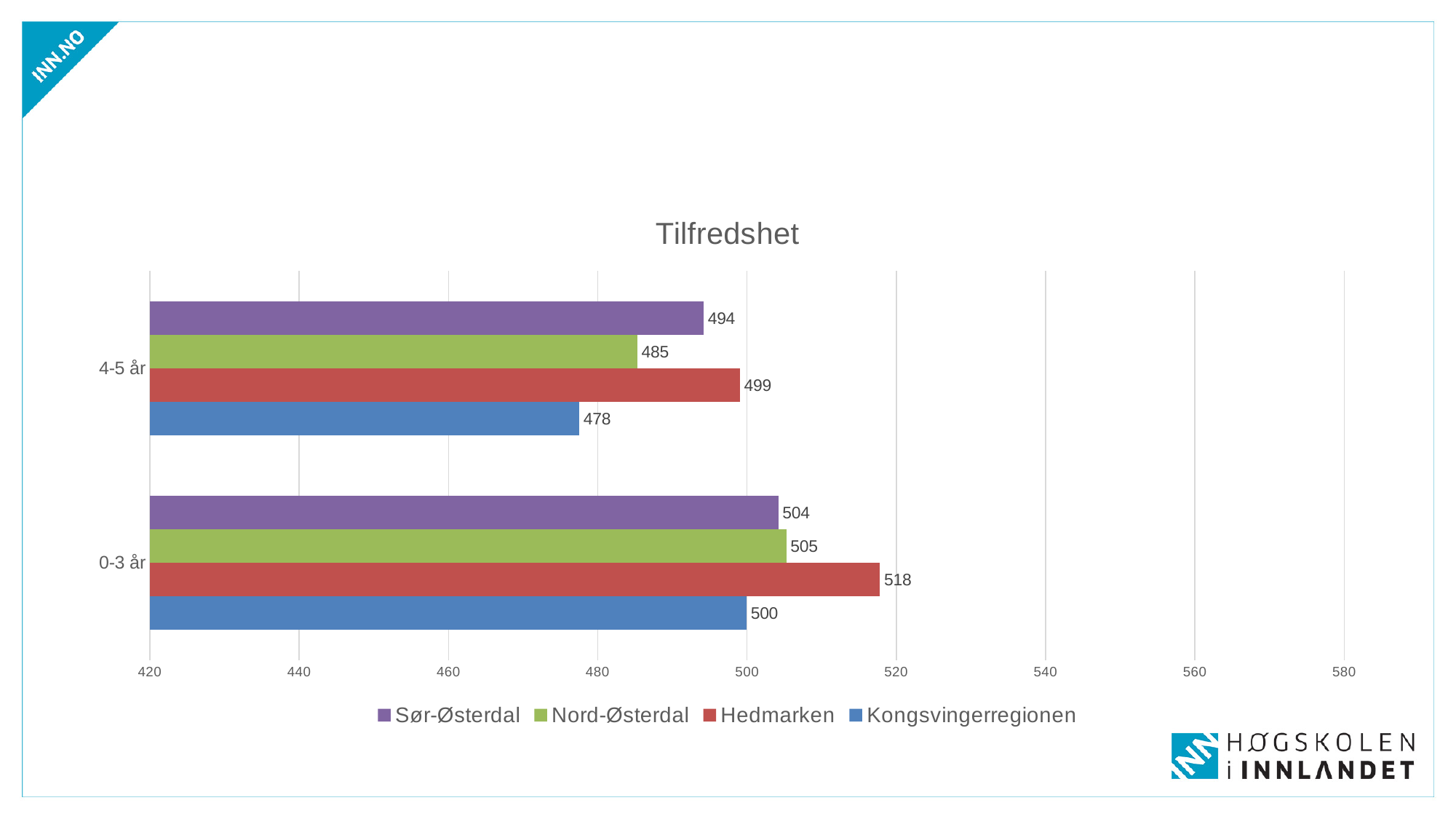
What is the value for Hedmarken in the 0-3 år category? 518 What is the value for Kongsvingerregionen in the 4-5 år category? 478 Which is larger: Sør-Østerdal for 4-5 år or Kongsvingerregionen for 4-5 år? Sør-Østerdal for 4-5 år How many categories are shown on the vertical axis? 2 Which series has the highest value in the 0-3 år category? Hedmarken What is the difference between the Hedmarken values for 0-3 år and 4-5 år? 19 What kind of chart is shown on the slide? bar chart What is the value for Nord-Østerdal in the 4-5 år category? 485 Which series has the lowest value in the 4-5 år category? Kongsvingerregionen Is the value for Kongsvingerregionen in the 4-5 år category greater or less than 480? less What is the title of the chart? Tilfredshet How many series does the legend list? 4